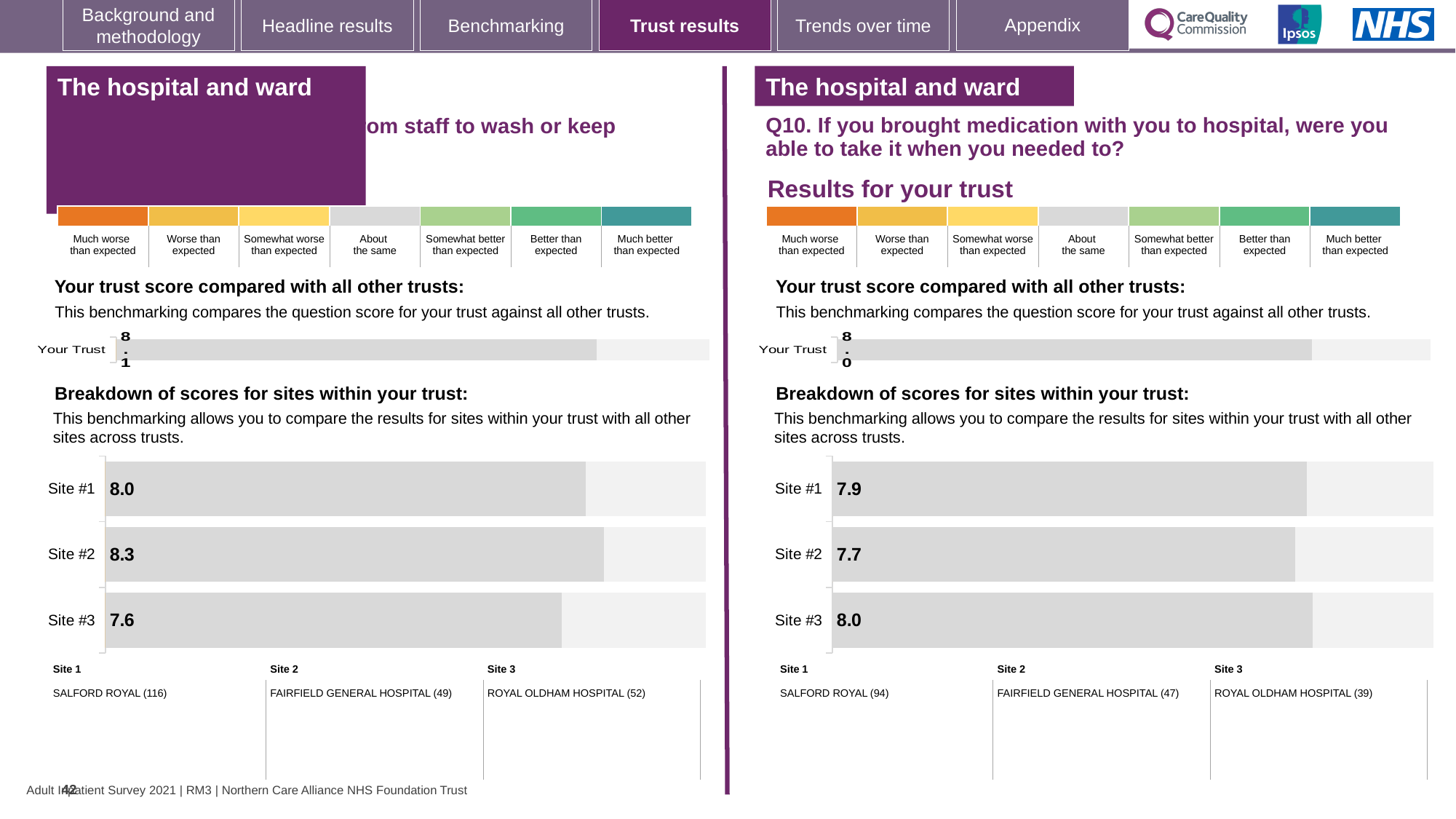
On the right-hand chart for Q10 (medication), what is the score for Site #2? 7.7 On the right-hand chart for Q10 (medication), what is the difference between the scores for Site #3 and Site #2? 0.3 On the right-hand chart for Q10 (medication), which is larger: the score for Site #1 or Site #2? Site #1 On the left-hand site breakdown chart, what is the difference between the scores for Site #2 and Site #3? 0.7 On the left-hand site breakdown chart, which site has the lowest score? Site #3 On the right-hand chart for Q10 (medication), what is the score for Site #3? 8.0 On the left-hand site breakdown chart, what is the score for Site #2? 8.3 On the left-hand site breakdown chart, what is the score for Site #3? 7.6 On the right-hand chart for Q10 (medication), what is the score for Site #1? 7.9 On the right-hand chart for Q10 (medication), which site has the lowest score? Site #2 How many sites are shown in the right-hand site breakdown chart for Q10? 3 On the left-hand site breakdown chart, which site has the highest score? Site #2